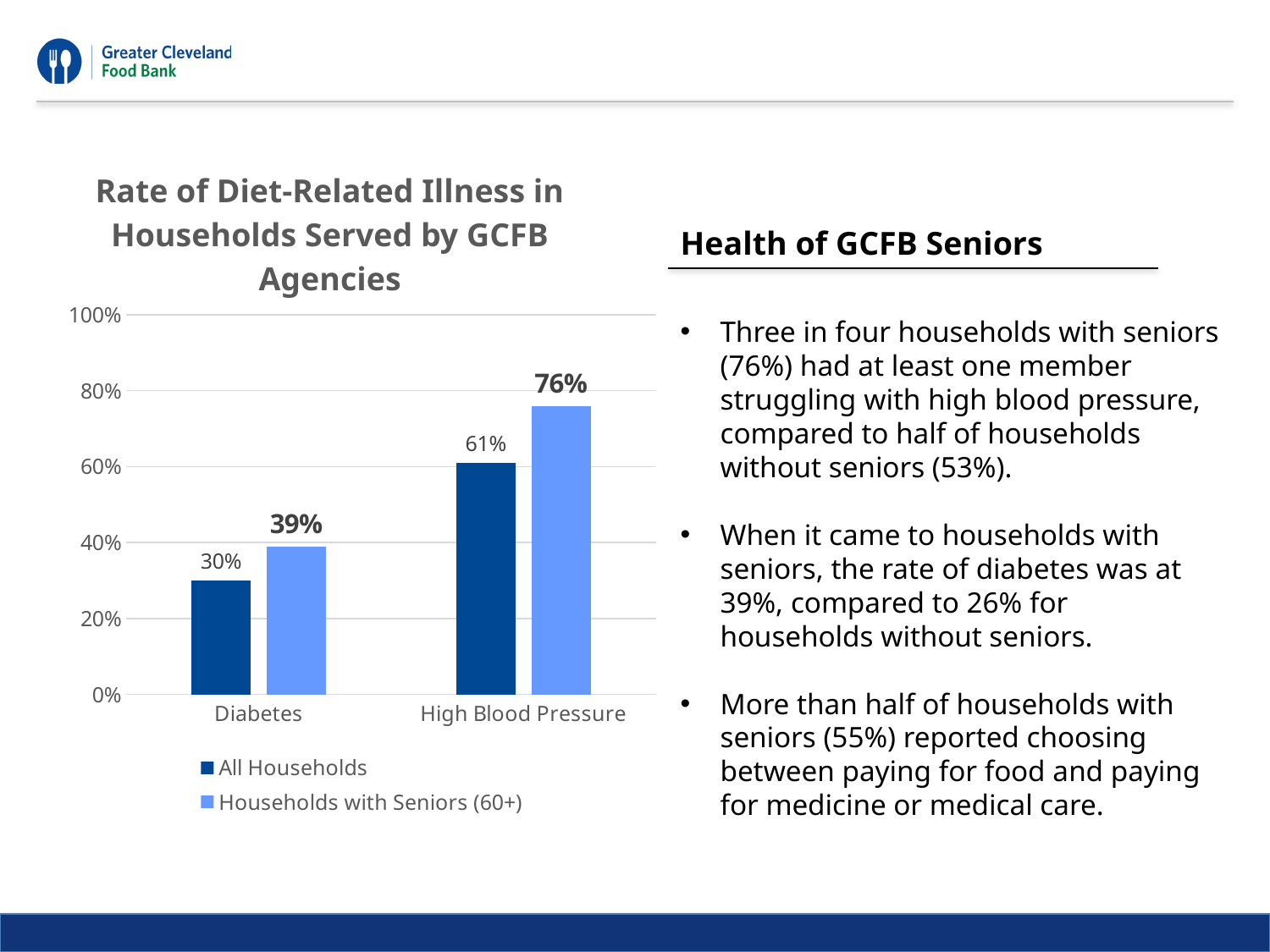
Which category has the highest value for Households with Seniors (60+)? High Blood Pressure How many series does the legend list? 2 What kind of chart is shown? Bar chart What is the value for Households with Seniors (60+) for High Blood Pressure? 76% What is the value for All Households for Diabetes? 30% What is the difference between Households with Seniors (60+) and All Households for High Blood Pressure? 15% Which is larger for Diabetes: All Households or Households with Seniors (60+)? Households with Seniors (60+) What is the difference between Households with Seniors (60+) and All Households for Diabetes? 9% How many categories are shown on the x axis? 2 What is the value for Households with Seniors (60+) for Diabetes? 39% What is the value for All Households for High Blood Pressure? 61% Which category has the lowest value for All Households? Diabetes